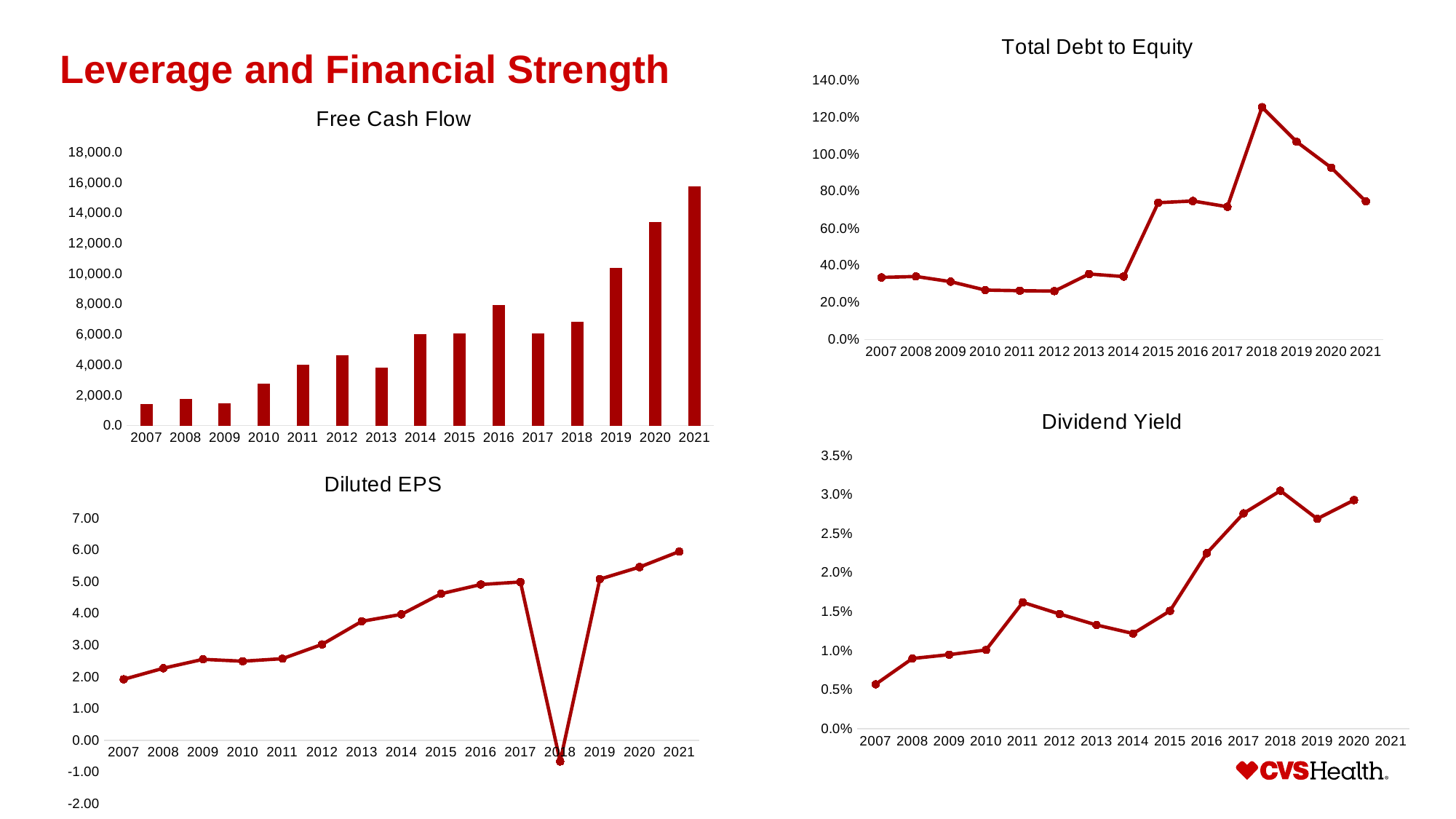
In the Free Cash Flow chart, do the values generally rise or fall from 2007 to 2021? rise In the Free Cash Flow chart, which is larger, the value for 2016 or the value for 2017? 2016 In the Free Cash Flow chart, which year has the highest value? 2021 In the Total Debt to Equity chart, is the value for 2021 greater or less than 80.0%? less In the Dividend Yield chart, which year has the lowest value? 2007 In the Diluted EPS chart, which year has the lowest value? 2018 In the Dividend Yield chart, is the value for 2016 greater or less than 2.0%? greater What kind of chart is the Free Cash Flow chart? bar chart In the Free Cash Flow chart, is the value for 2020 greater or less than 12,000.0? greater How many years are shown on the x axis of the Free Cash Flow chart? 15 In the Total Debt to Equity chart, which year has the highest value? 2018